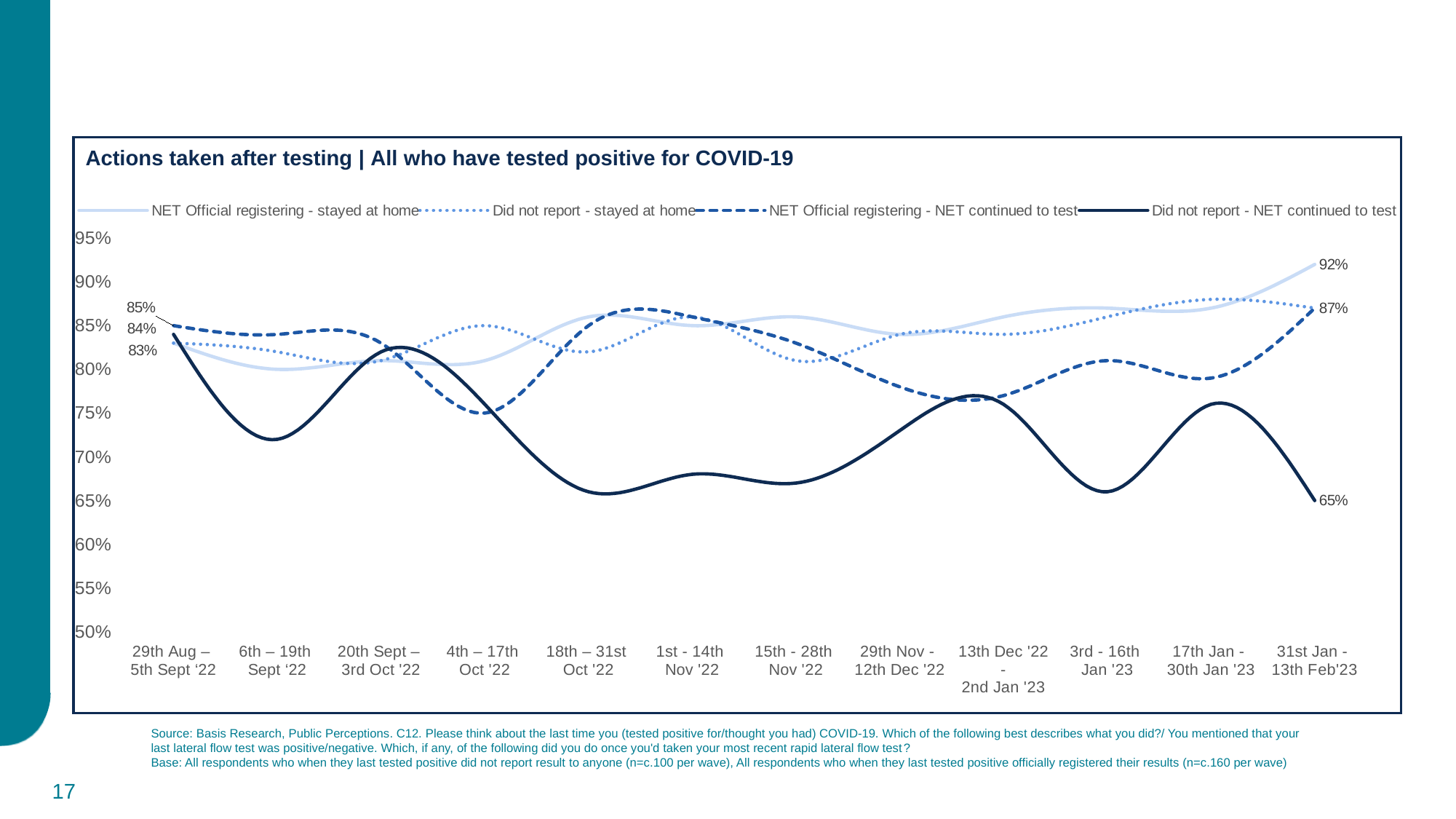
What is the value for NET Official registering - stayed at home in the 31st Jan - 13th Feb '23 period? 92% What is the title of the chart? Actions taken after testing | All who have tested positive for COVID-19 Does Did not report - NET continued to test rise or fall from the 17th Jan - 30th Jan '23 period to the 31st Jan - 13th Feb'23 period? Fall What is the value for Did not report - NET continued to test in the 31st Jan - 13th Feb '23 period? 65% Which series has the lowest value in the 31st Jan - 13th Feb '23 period? Did not report - NET continued to test How many series does the legend list? 4 How many time periods are shown on the x axis? 12 What kind of chart is this? Line chart In which period does NET Official registering - stayed at home reach its highest value? 31st Jan - 13th Feb '23 What is the difference between NET Official registering - stayed at home and Did not report - NET continued to test in the 31st Jan - 13th Feb '23 period? 27 percentage points Is the value for Did not report - NET continued to test in the 18th – 31st Oct '22 period greater or less than 70%? less What is the value for NET Official registering - NET continued to test in the 29th Aug – 5th Sept '22 period? 85%